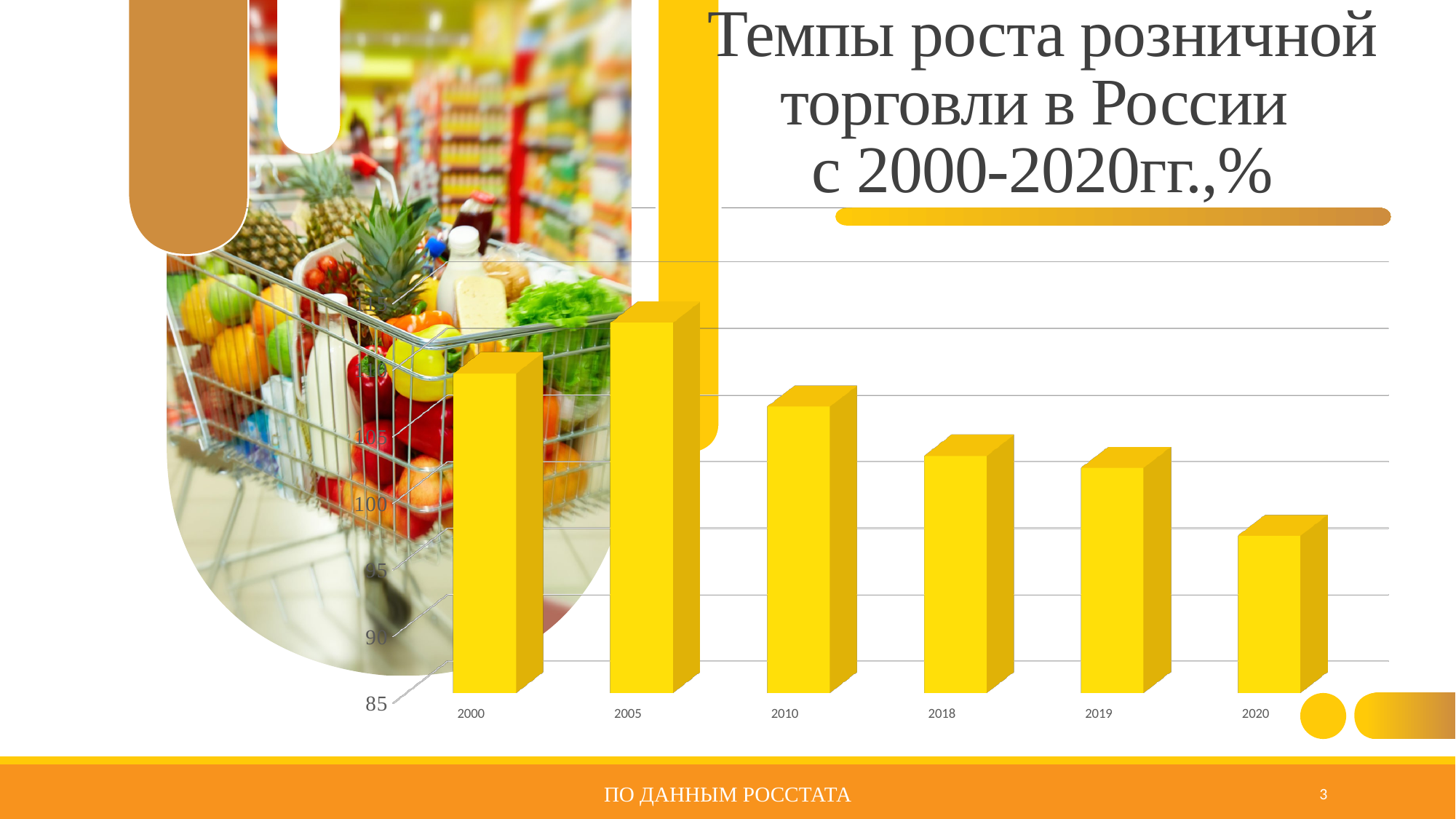
Which year has the highest bar on the chart? 2005 Is the value for 2020 greater or less than 100? less Is the value for 2018 greater or less than 95? greater What kind of chart is shown on the slide? Bar chart Which year has the larger value, 2000 or 2010? 2000 Is the value for 2010 greater or less than 100? greater What is the title of the chart on the slide? Темпы роста розничной торговли в России с 2000-2020гг.,% How many years (categories) are plotted on the chart? 6 Do the values rise or fall from 2005 to 2020? fall Which year has the lowest bar on the chart? 2020 Which year has the larger value, 2005 or 2020? 2005